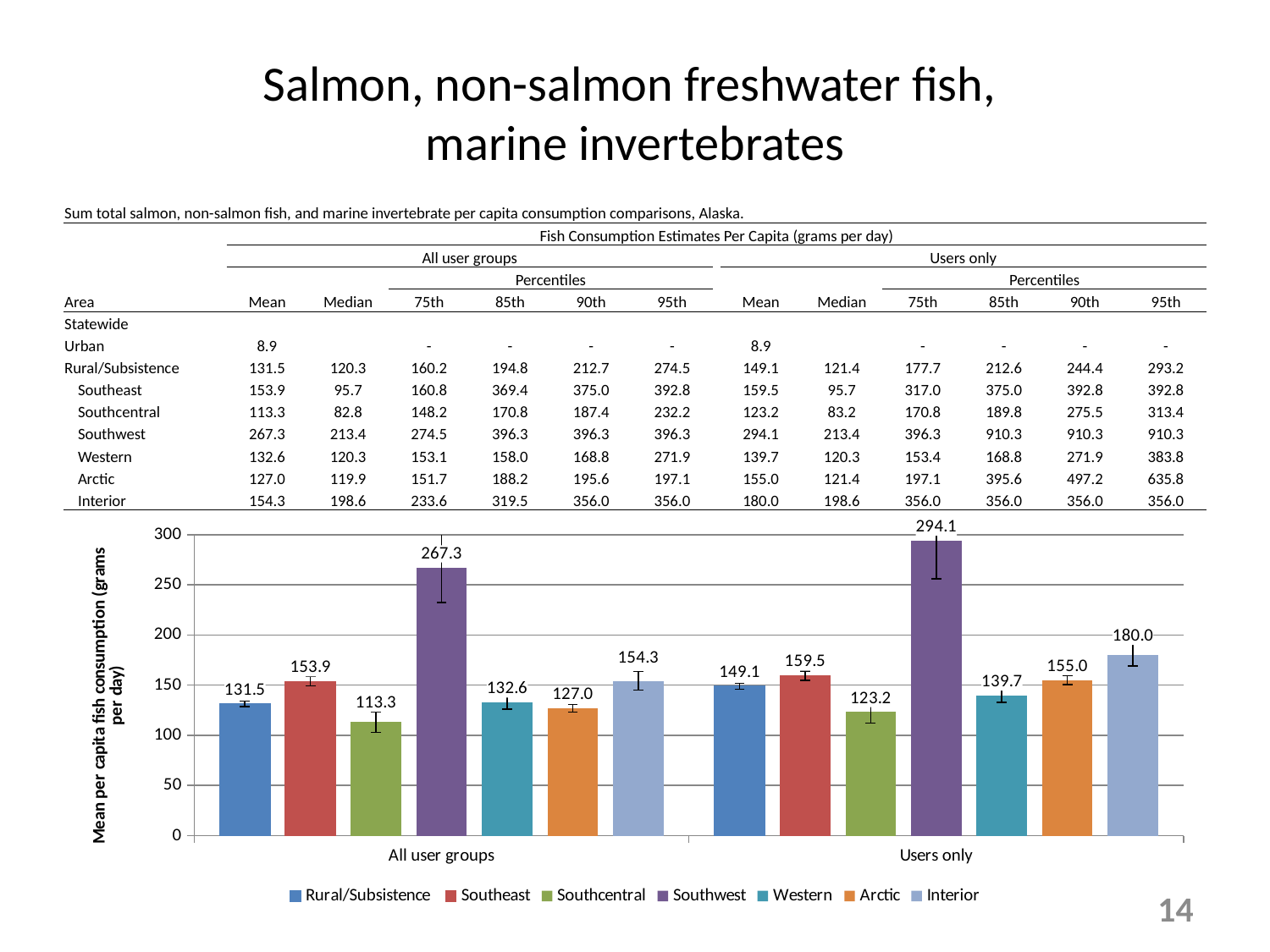
What type of chart is shown on the slide? bar chart How many series does the chart legend list? 7 Is the value for Interior in the Users only category greater or less than 150? greater What is the mean per capita fish consumption for Southwest in the All user groups category? 267.3 What is the value for Southcentral in the All user groups category? 113.3 What is the value for Interior in the Users only category? 180.0 What is the label of the chart's y axis? Mean per capita fish consumption (grams per day) How many categories are shown on the x axis of the chart? 2 Which is larger: the Arctic value for All user groups or the Arctic value for Users only? Users only Which series has the lowest value in the All user groups category? Southcentral What is the difference between the Southwest values for Users only and All user groups? 26.8 Which series has the highest value in the Users only category? Southwest